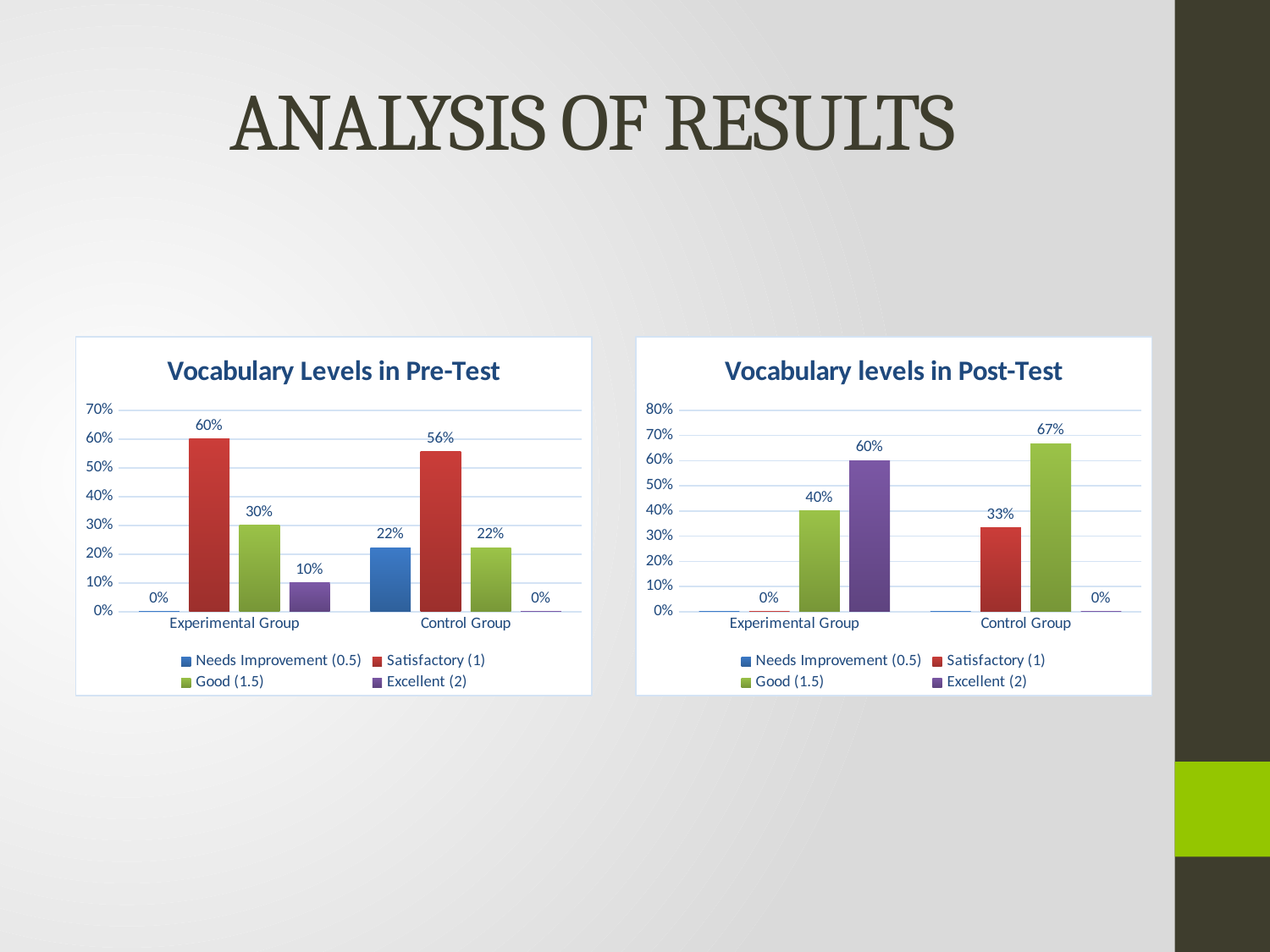
In the Vocabulary levels in Post-Test chart, what is the value for Excellent (2) in the Experimental Group? 60% In the Vocabulary Levels in Pre-Test chart, what is the value for Needs Improvement (0.5) in the Control Group? 22% How many series does the legend of the Vocabulary Levels in Pre-Test chart list? 4 In the Vocabulary Levels in Pre-Test chart, which series has the highest value in the Control Group? Satisfactory (1) In the Vocabulary levels in Post-Test chart, what is the value for Good (1.5) in the Control Group? 67% What kind of chart is the Vocabulary levels in Post-Test chart? Bar chart In the Vocabulary Levels in Pre-Test chart, what is the difference between the Satisfactory (1) values for the Experimental Group and the Control Group? 4% In the Vocabulary levels in Post-Test chart, what is the value for Satisfactory (1) in the Control Group? 33% In the Vocabulary Levels in Pre-Test chart, what is the value for Excellent (2) in the Experimental Group? 10% In the Vocabulary Levels in Pre-Test chart, what is the value for Satisfactory (1) in the Experimental Group? 60% In the Vocabulary levels in Post-Test chart, what is the difference between Good (1.5) and Satisfactory (1) in the Control Group? 34% In the Vocabulary levels in Post-Test chart, which is larger for the Experimental Group: Good (1.5) or Excellent (2)? Excellent (2)